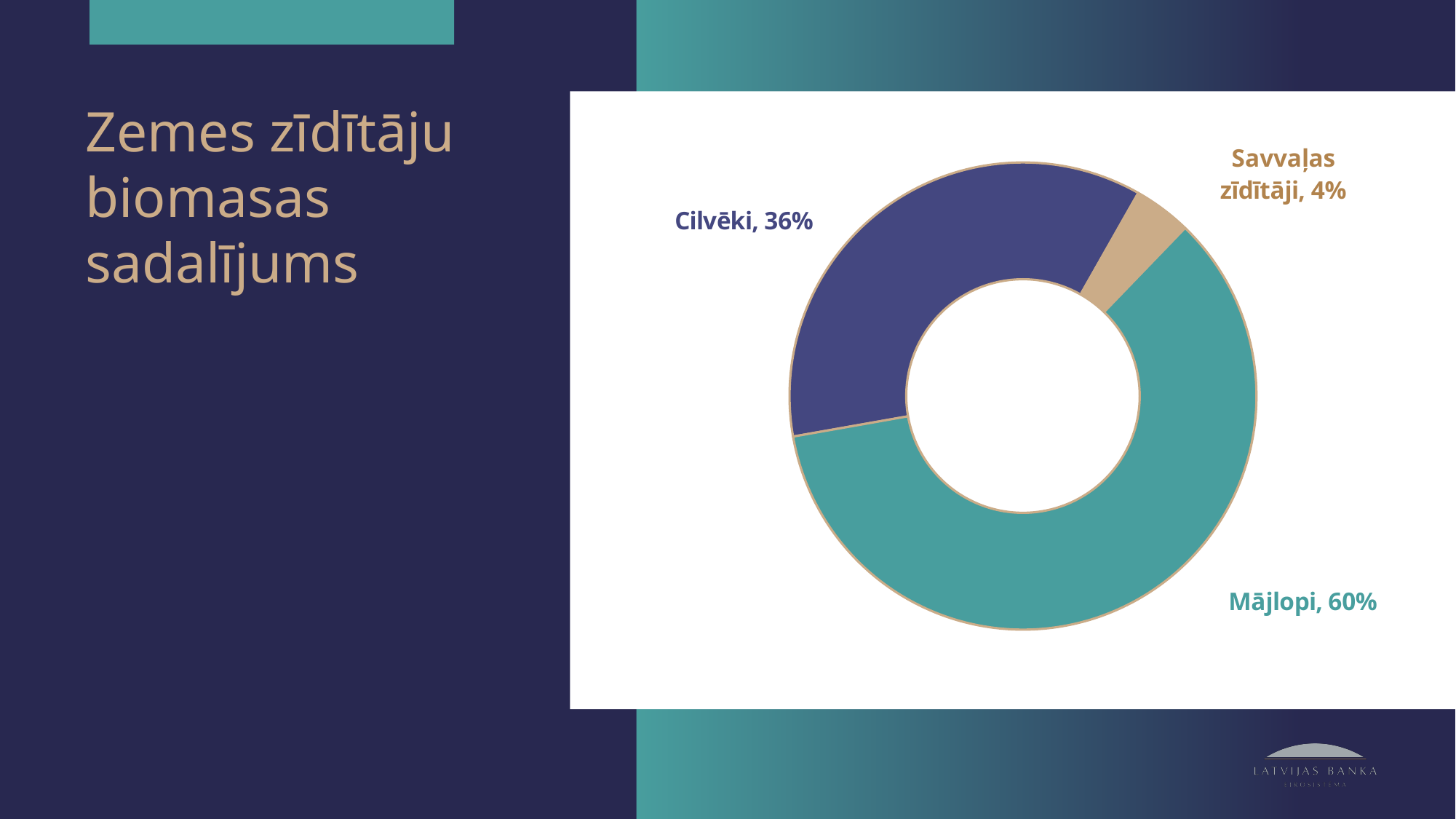
How many categories are shown in the chart? 3 What colour is the Mājlopi slice? Teal Which category has the largest share? Mājlopi What kind of chart is shown on the slide? Pie chart (doughnut) What is the difference in percentage points between Cilvēki and Savvaļas zīdītāji? 32 What share of the chart does Mājlopi represent? 60% What share of the chart does Cilvēki represent? 36% What is the difference in percentage points between Mājlopi and Cilvēki? 24 Which category has the smallest share? Savvaļas zīdītāji What is the title of the slide? Zemes zīdītāju biomasas sadalījums What share of the chart does Savvaļas zīdītāji represent? 4% Which is larger, the share for Cilvēki or the share for Savvaļas zīdītāji? Cilvēki